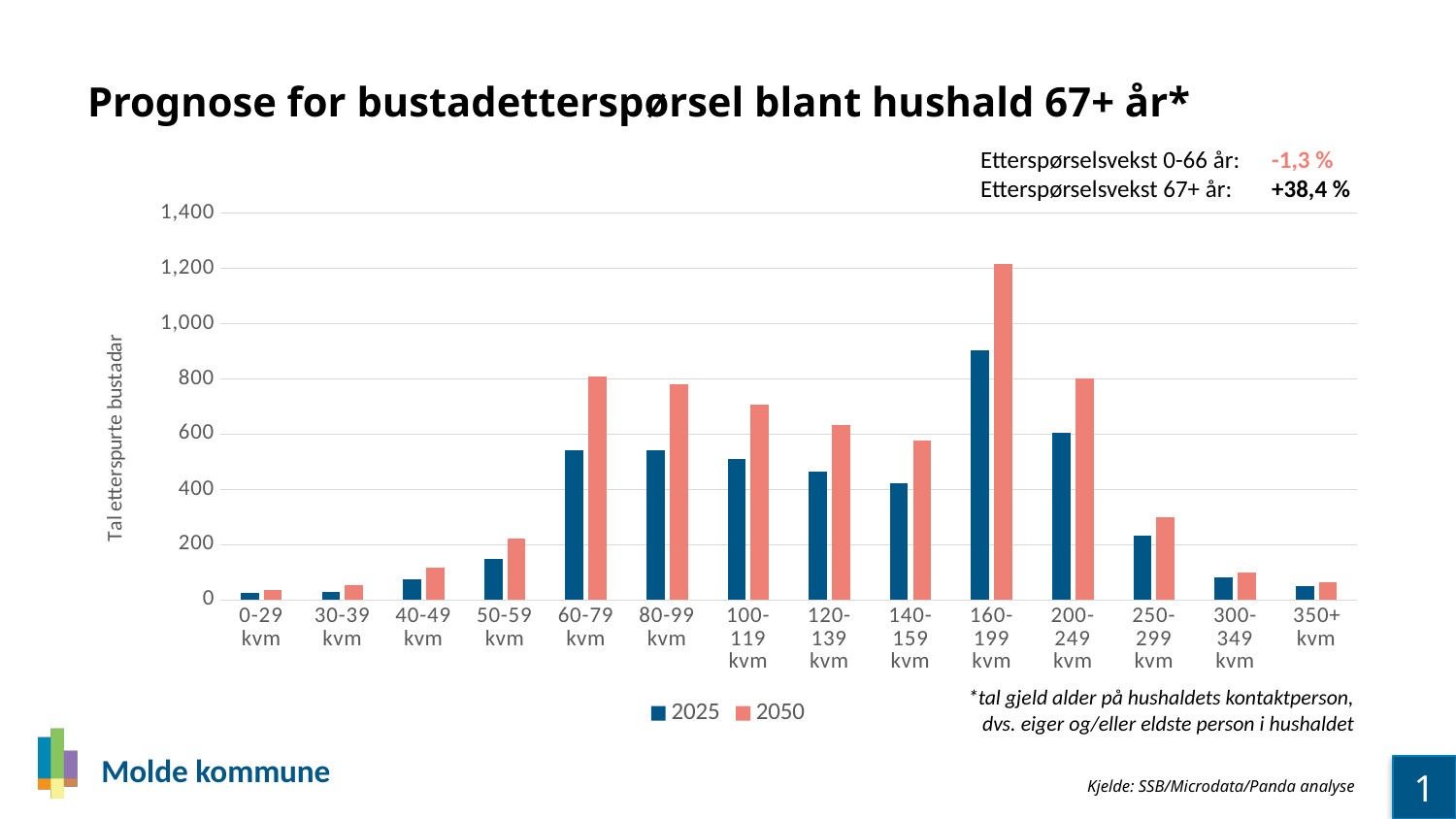
Is the 2025 value for 50-59 kvm greater or less than 200? less How many size categories (kvm groups) are shown on the x axis? 14 What are the two entries in the chart legend? 2025 and 2050 How many series does the legend list? 2 Is the 2050 value for 160-199 kvm greater or less than 1,000? greater Is the 2050 value for 200-249 kvm greater or less than 600? greater What kind of chart is shown on the slide? Bar chart For the 2025 series, which is larger: 200-249 kvm or 250-299 kvm? 200-249 kvm Which size category has the highest value for the 2025 series? 160-199 kvm Which size category has the highest value for the 2050 series? 160-199 kvm For 60-79 kvm, which series has the larger value, 2025 or 2050? 2050